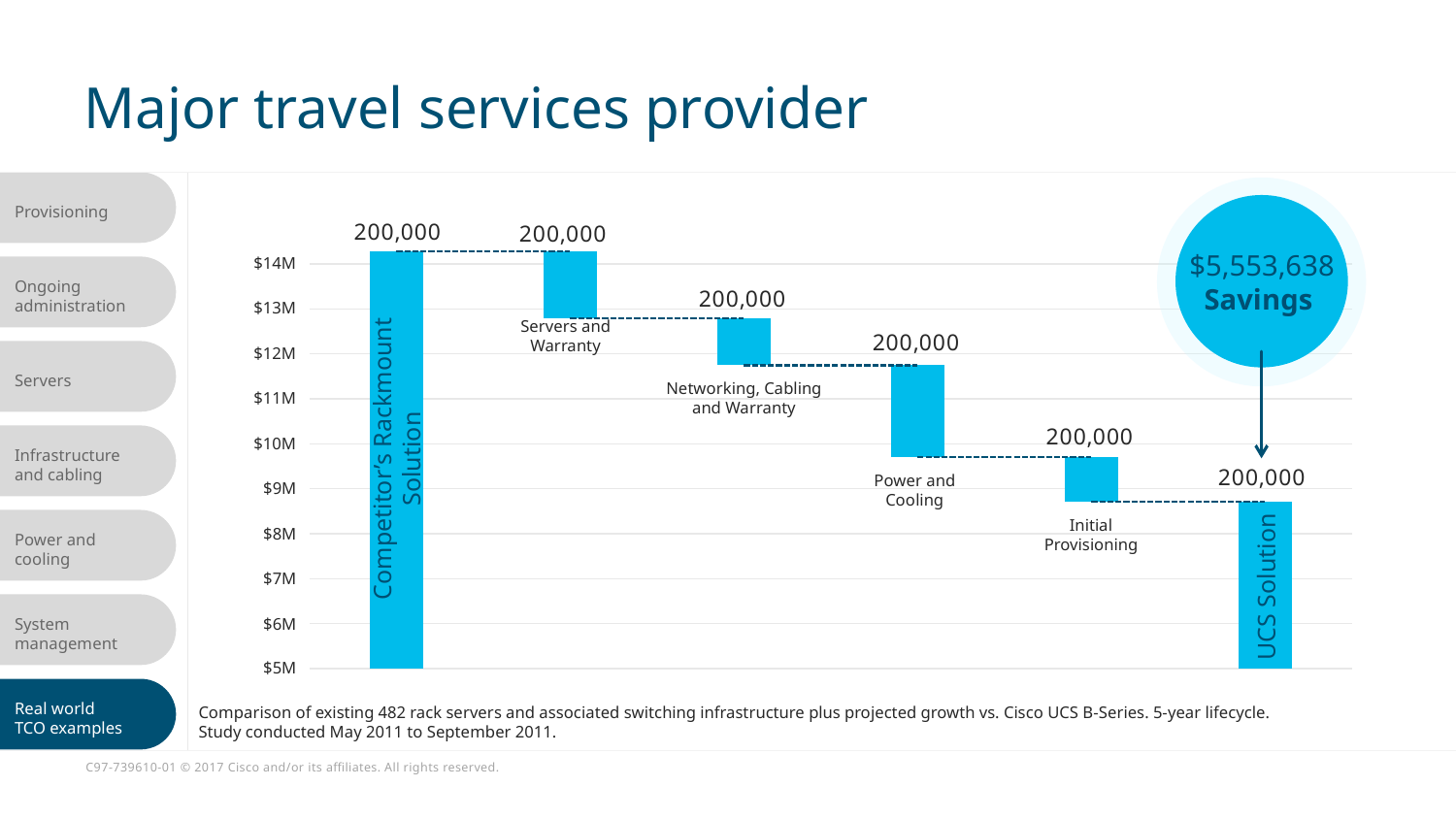
What savings amount is shown in the circle on the chart? $5,553,638 What kind of chart is shown on the slide? waterfall chart What data label is printed above the Power and Cooling bar? 200,000 Is the top of the Competitor's Rackmount Solution bar greater or less than $13M? greater Among the intermediate step bars (Servers and Warranty, Networking Cabling and Warranty, Power and Cooling, Initial Provisioning), which represents the largest drop? Power and Cooling What data label is printed above the UCS Solution bar? 200,000 Do the cumulative values rise or fall moving from the Competitor's Rackmount Solution bar to the UCS Solution bar? fall Which bar reaches higher on the chart, Competitor's Rackmount Solution or UCS Solution? Competitor's Rackmount Solution What is the title of the slide containing the chart? Major travel services provider Is the top of the UCS Solution bar greater or less than $9M? less How many bars are plotted in the chart? 6 What is the lowest value shown on the vertical axis? $5M